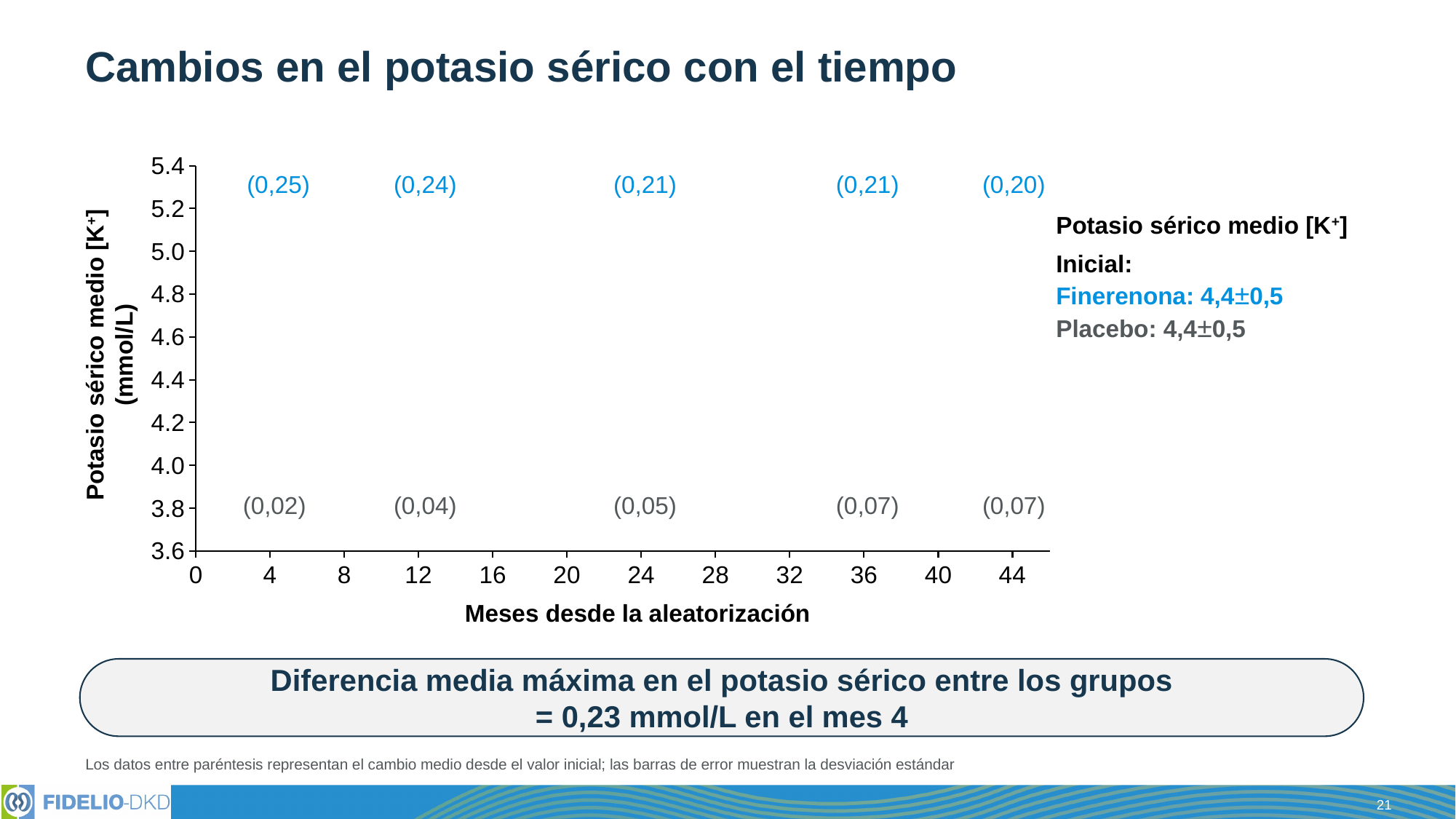
At which month is the placebo mean change from baseline the lowest? 4 What is the mean change from baseline shown for finerenone at month 24? 0,21 What is the mean change from baseline shown for placebo (grey label) at month 44? 0,07 At month 44, which group shows the larger mean change from baseline, finerenone or placebo? Finerenona At which month is the finerenone mean change from baseline the highest? 4 What is the mean change from baseline in serum potassium shown for finerenone (blue label) at month 4? 0,25 What is the difference between the finerenone and placebo mean changes from baseline at month 4? 0,23 How many time points have mean-change labels printed on the chart? 5 What is the mean change from baseline shown for placebo at month 12? 0,04 Do the finerenone mean-change values rise or fall from month 4 to month 44? fall What baseline mean serum potassium is given for placebo in the text beside the chart? 4,4±0,5 What is the label of the x axis? Meses desde la aleatorización